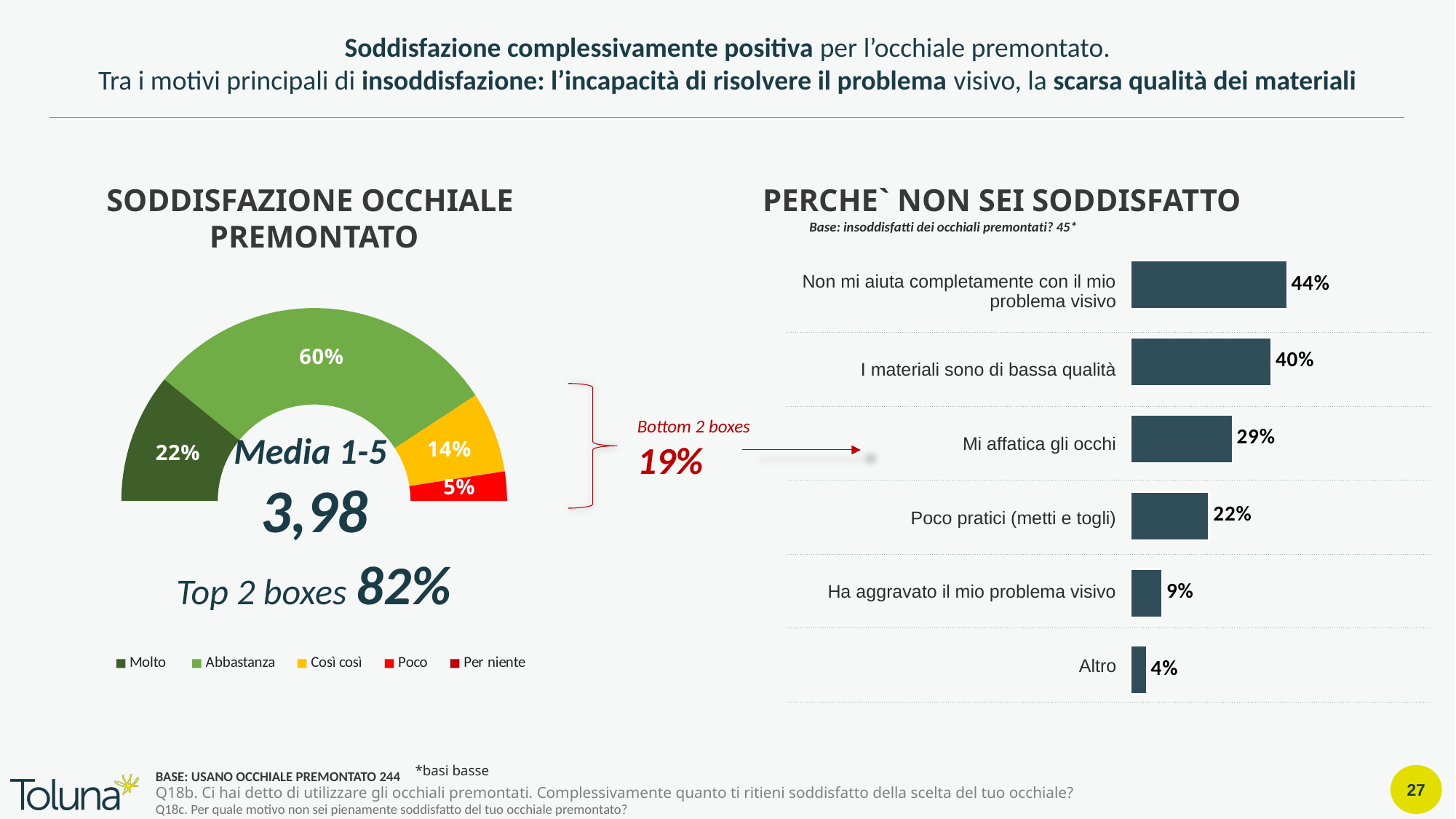
In the 'SODDISFAZIONE OCCHIALE PREMONTATO' chart, what is the share for 'Abbastanza'? 60% In the 'PERCHE` NON SEI SODDISFATTO' chart, which is larger: 'Ha aggravato il mio problema visivo' or 'Altro'? Ha aggravato il mio problema visivo In the 'PERCHE` NON SEI SODDISFATTO' chart, what is the difference between 'Non mi aiuta completamente con il mio problema visivo' and 'Poco pratici (metti e togli)'? 22% What kind of chart is 'PERCHE` NON SEI SODDISFATTO'? Bar chart In the 'SODDISFAZIONE OCCHIALE PREMONTATO' chart, what is the share for 'Molto'? 22% In the 'PERCHE` NON SEI SODDISFATTO' chart, which reason has the highest value? Non mi aiuta completamente con il mio problema visivo In the 'PERCHE` NON SEI SODDISFATTO' chart, what is the value for 'Mi affatica gli occhi'? 29% In the 'SODDISFAZIONE OCCHIALE PREMONTATO' chart, what colour is the 'Così così' segment? Yellow How many reasons are listed in the 'PERCHE` NON SEI SODDISFATTO' chart? 6 How many entries does the legend of the 'SODDISFAZIONE OCCHIALE PREMONTATO' chart list? 5 In the 'PERCHE` NON SEI SODDISFATTO' chart, which reason has the lowest value? Altro In the 'PERCHE` NON SEI SODDISFATTO' chart, what is the value for 'I materiali sono di bassa qualità'? 40%